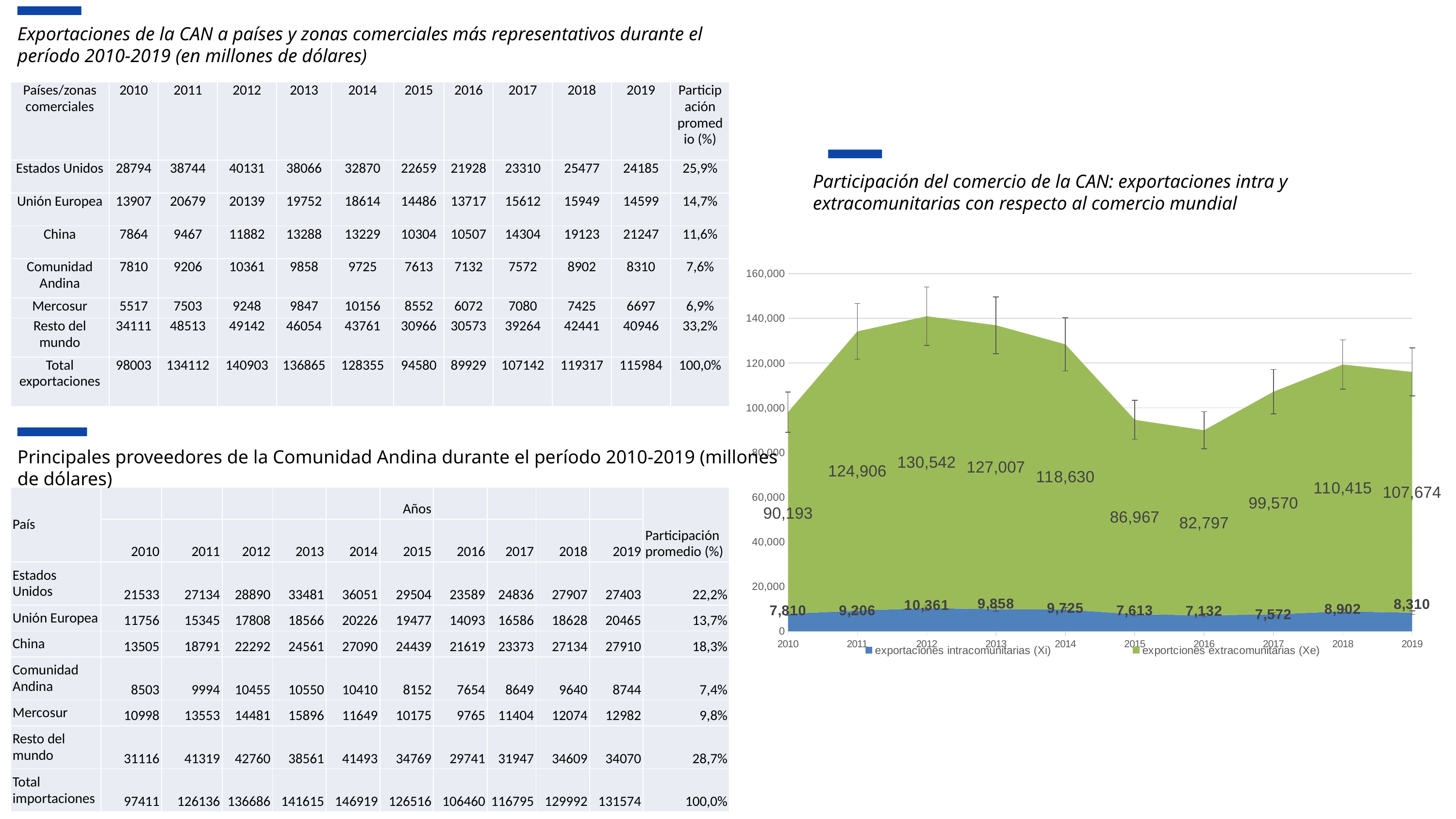
Which is larger, exportciones extracomunitarias (Xe) in 2011 or in 2019? 2011 How many years are plotted along the x axis of the chart? 10 What type of chart is shown on the slide? area chart What is the difference between exportciones extracomunitarias (Xe) in 2012 and in 2016? 47,745 In which year is exportciones extracomunitarias (Xe) lowest? 2016 In which year is exportciones extracomunitarias (Xe) highest? 2012 What is the total of the two series in 2010? 98,003 In which year is exportaciones intracomunitarias (Xi) lowest? 2016 Does exportciones extracomunitarias (Xe) rise or fall from 2015 to 2018? rise How many series does the chart legend list? 2 What is the value of exportciones extracomunitarias (Xe) in 2012? 130,542 What is the value of exportaciones intracomunitarias (Xi) in 2019? 8,310